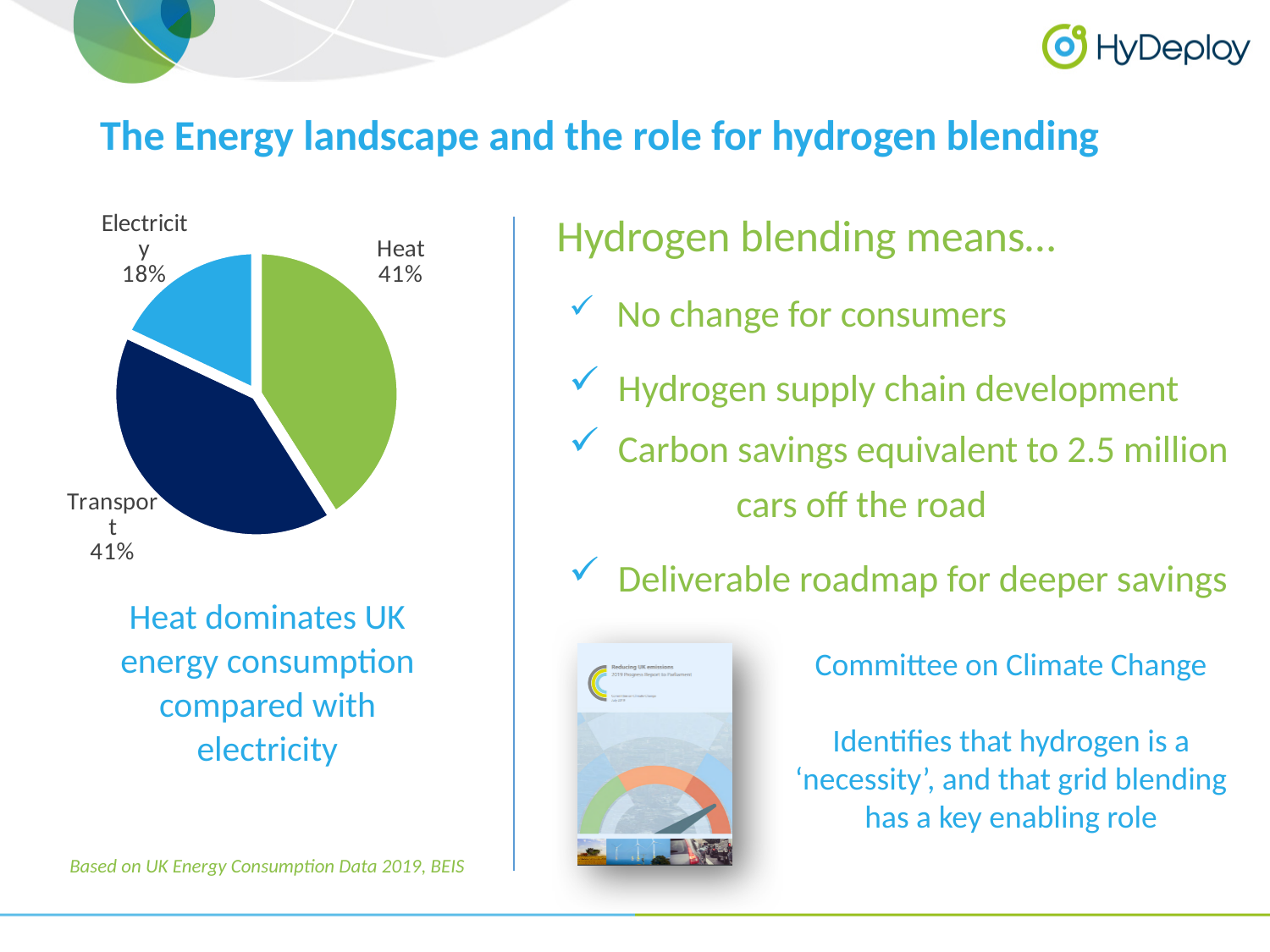
What is the difference in percentage points between the Transport slice and the Electricity slice? 23 What is the difference in percentage points between the Heat slice and the Electricity slice? 23 How many slices does the pie chart have? 3 Which is larger in the pie chart, Transport or Electricity? Transport What kind of chart is shown on the slide? pie chart Which is larger in the pie chart, Heat or Electricity? Heat What share of the pie does Transport account for? 41% What share of the pie does Heat account for? 41% Which category has the smallest slice of the pie chart? Electricity What colour is the Heat slice in the pie chart? green What data source is cited beneath the pie chart? UK Energy Consumption Data 2019, BEIS What is the value shown for Electricity in the pie chart? 18%